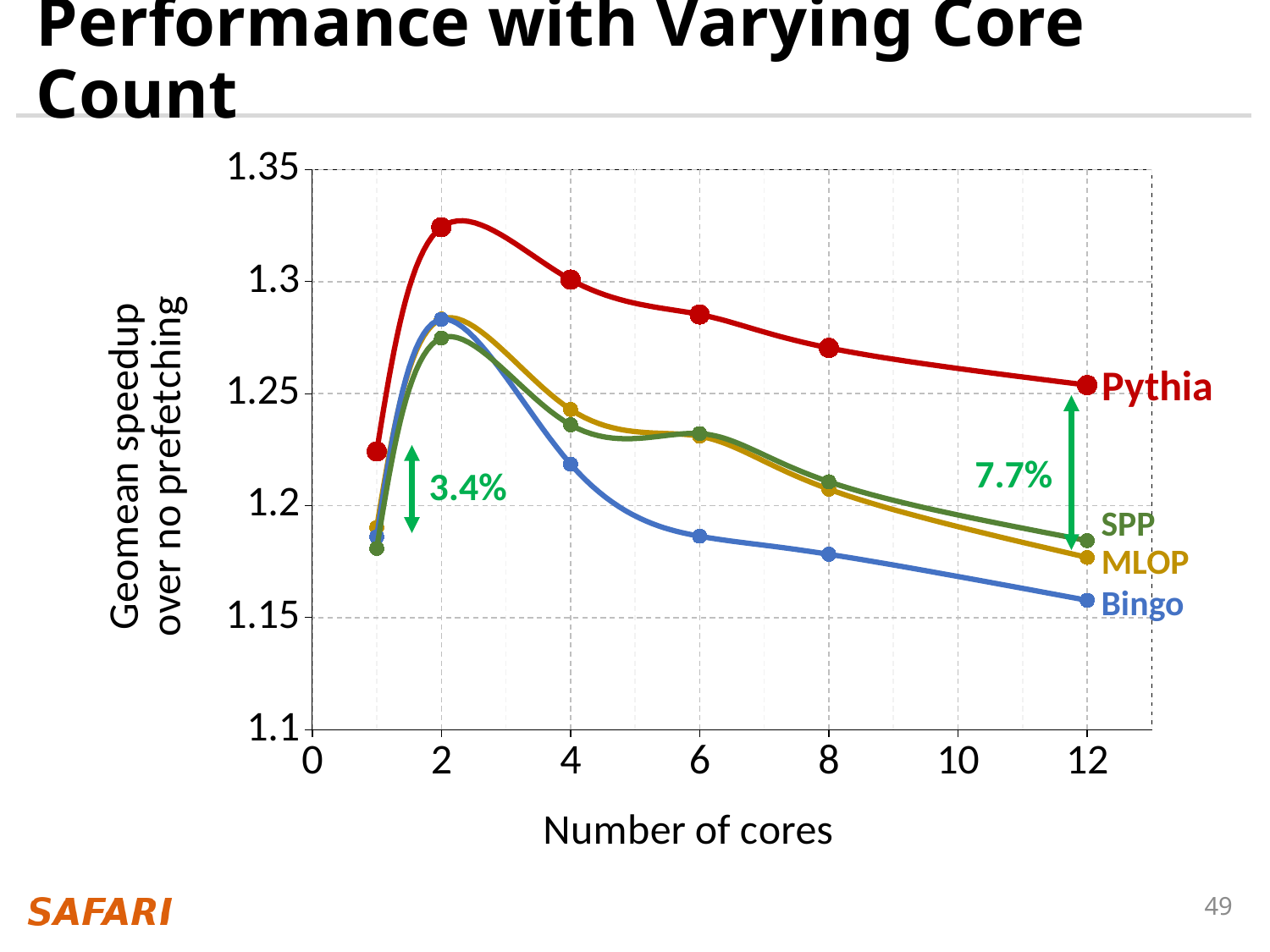
What is the label of the x axis? Number of cores How many series (prefetchers) are plotted in the chart? 4 What kind of chart is shown on the slide? line chart Which prefetcher has the highest geomean speedup at 12 cores? Pythia Does the geomean speedup for Pythia rise or fall as the number of cores increases from 2 to 12? fall At 8 cores, which has the higher geomean speedup, SPP or Bingo? SPP At 4 cores, which has the higher geomean speedup, Pythia or Bingo? Pythia Which prefetcher has the lowest geomean speedup at 12 cores? Bingo Is the geomean speedup for Pythia at 2 cores greater or less than 1.3? greater At which number of cores does Pythia reach its highest geomean speedup? 2 Is the geomean speedup for Pythia at 1 core greater or less than 1.2? greater Is the geomean speedup for Bingo at 12 cores greater or less than 1.2? less